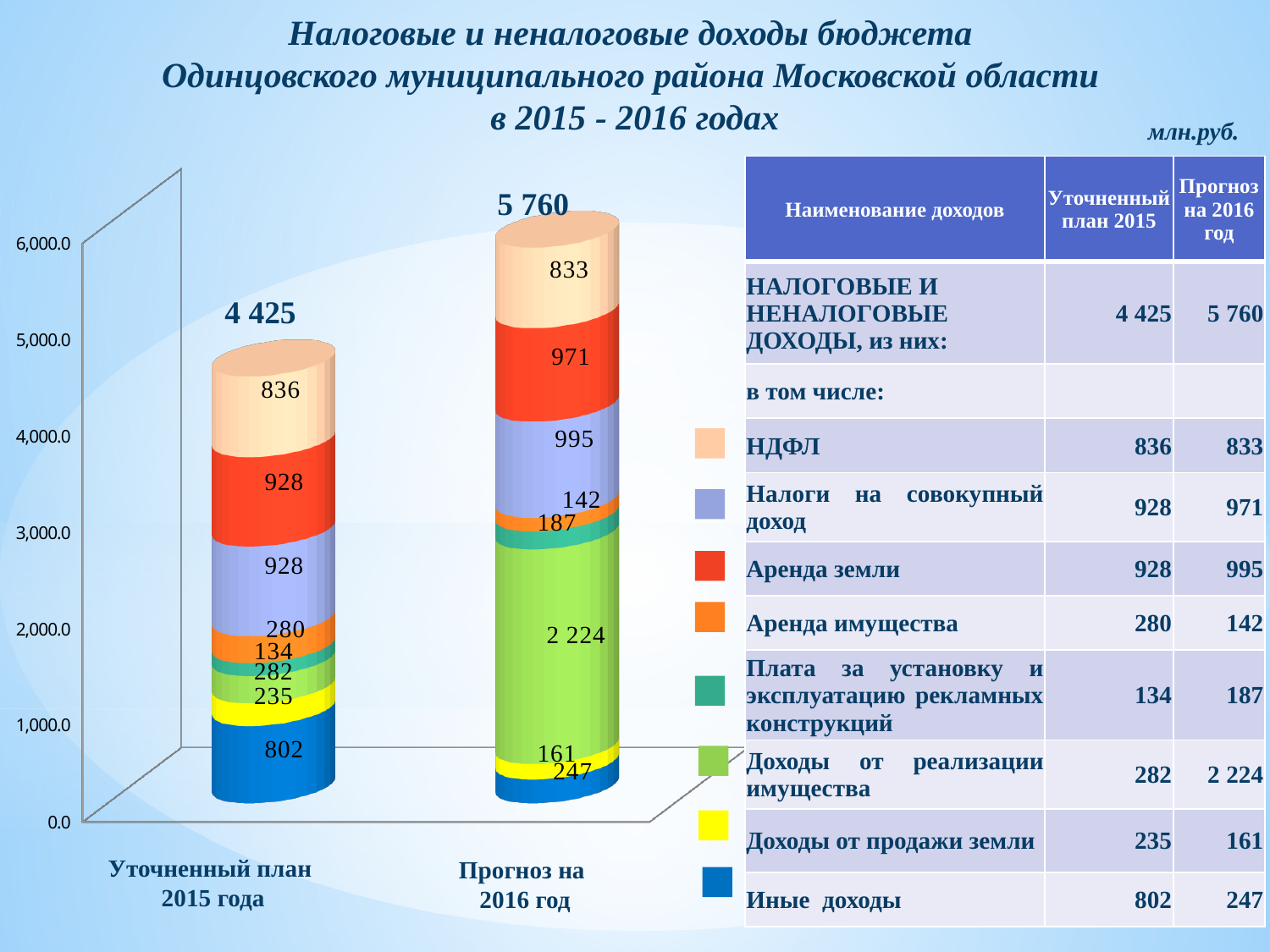
What kind of chart is shown on the slide? Stacked bar chart What is the value of the НДФЛ segment in the Уточненный план 2015 года bar? 836 How many bars does the chart contain? 2 What is the total value of the bar for Уточненный план 2015 года? 4 425 By how much does the Иные доходы segment decrease from Уточненный план 2015 года to Прогноз на 2016 год? 555 What is the value of the Доходы от реализации имущества segment in the Прогноз на 2016 год bar? 2 224 Which bar is taller, Уточненный план 2015 года or Прогноз на 2016 год? Прогноз на 2016 год What is the value of the Иные доходы segment in the Прогноз на 2016 год bar? 247 What is the difference between the total for Прогноз на 2016 год and the total for Уточненный план 2015 года? 1 335 What is the total value of the bar for Прогноз на 2016 год? 5 760 What is the value of the Аренда имущества segment in the Прогноз на 2016 год bar? 142 In what units are the values on the slide expressed? млн.руб.